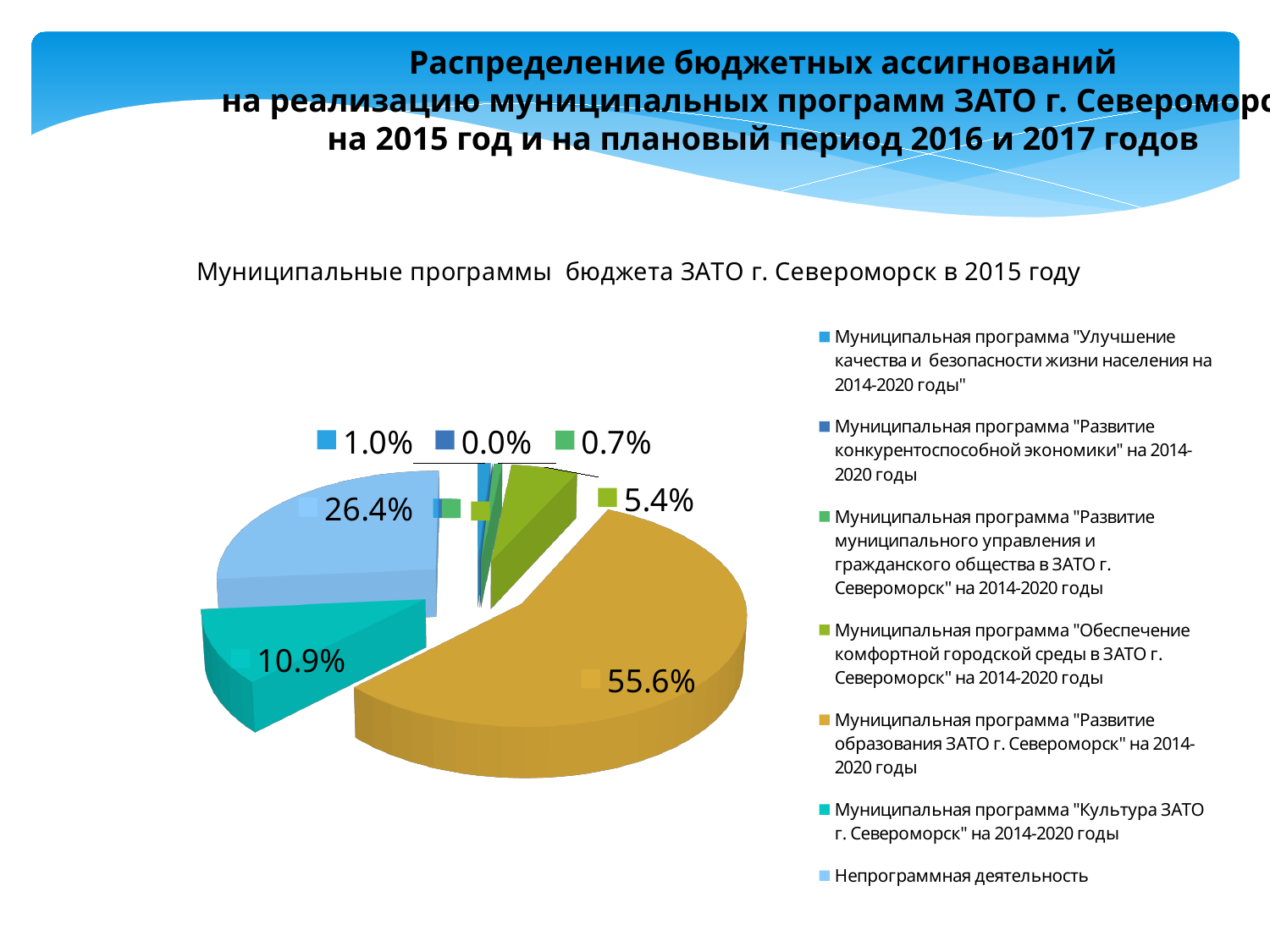
What share of the pie does the Муниципальная программа "Культура ЗАТО г. Североморск" на 2014-2020 годы have? 10.9% What is the chart's title? Муниципальные программы бюджета ЗАТО г. Североморск в 2015 году What share of the pie does the Муниципальная программа "Обеспечение комфортной городской среды в ЗАТО г. Североморск" на 2014-2020 годы have? 5.4% What is the difference between the share for Непрограммная деятельность and the share for the Муниципальная программа "Культура ЗАТО г. Североморск" на 2014-2020 годы? 15.5% How many slices does the pie chart have? 7 Which category has the largest share of the pie? Муниципальная программа "Развитие образования ЗАТО г. Североморск" на 2014-2020 годы What share of the pie does Непрограммная деятельность have? 26.4% What share of the pie does the Муниципальная программа "Развитие образования ЗАТО г. Североморск" на 2014-2020 годы have? 55.6% How many entries does the legend list? 7 What kind of chart is shown on the slide? pie chart Which category has the smallest share of the pie? Муниципальная программа "Развитие конкурентоспособной экономики" на 2014-2020 годы Which is larger: the share for the Муниципальная программа "Улучшение качества и безопасности жизни населения на 2014-2020 годы" or the share for the Муниципальная программа "Обеспечение комфортной городской среды в ЗАТО г. Североморск" на 2014-2020 годы? Муниципальная программа "Обеспечение комфортной городской среды в ЗАТО г. Североморск" на 2014-2020 годы